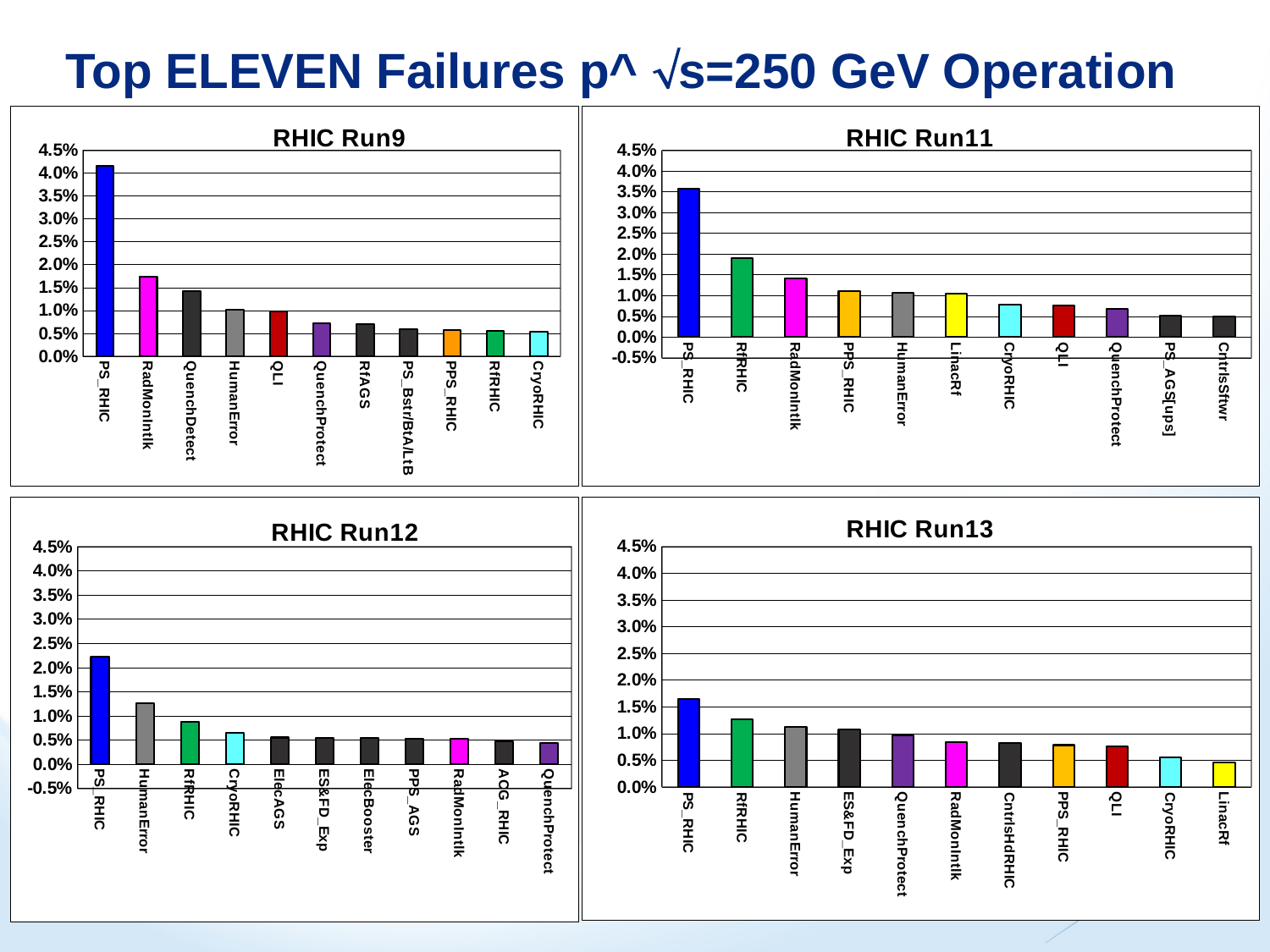
In the RHIC Run9 chart, which category has the highest value? PS_RHIC In the RHIC Run11 chart, how many categories are plotted? 11 In the RHIC Run11 chart, is the value for PS_RHIC greater or less than 3.0%? greater In the RHIC Run9 chart, is the value for RadMonIntlk greater or less than 1.5%? greater In the RHIC Run12 chart, is the value for PS_RHIC greater or less than 2.0%? greater What kind of chart is the RHIC Run12 chart? bar chart In the RHIC Run12 chart, which is larger, HumanError or RfRHIC? HumanError In the RHIC Run11 chart, which is larger, RfRHIC or RadMonIntlk? RfRHIC In the RHIC Run13 chart, do the values rise or fall from left to right along the x axis? fall In the RHIC Run13 chart, which category has the highest value? PS_RHIC